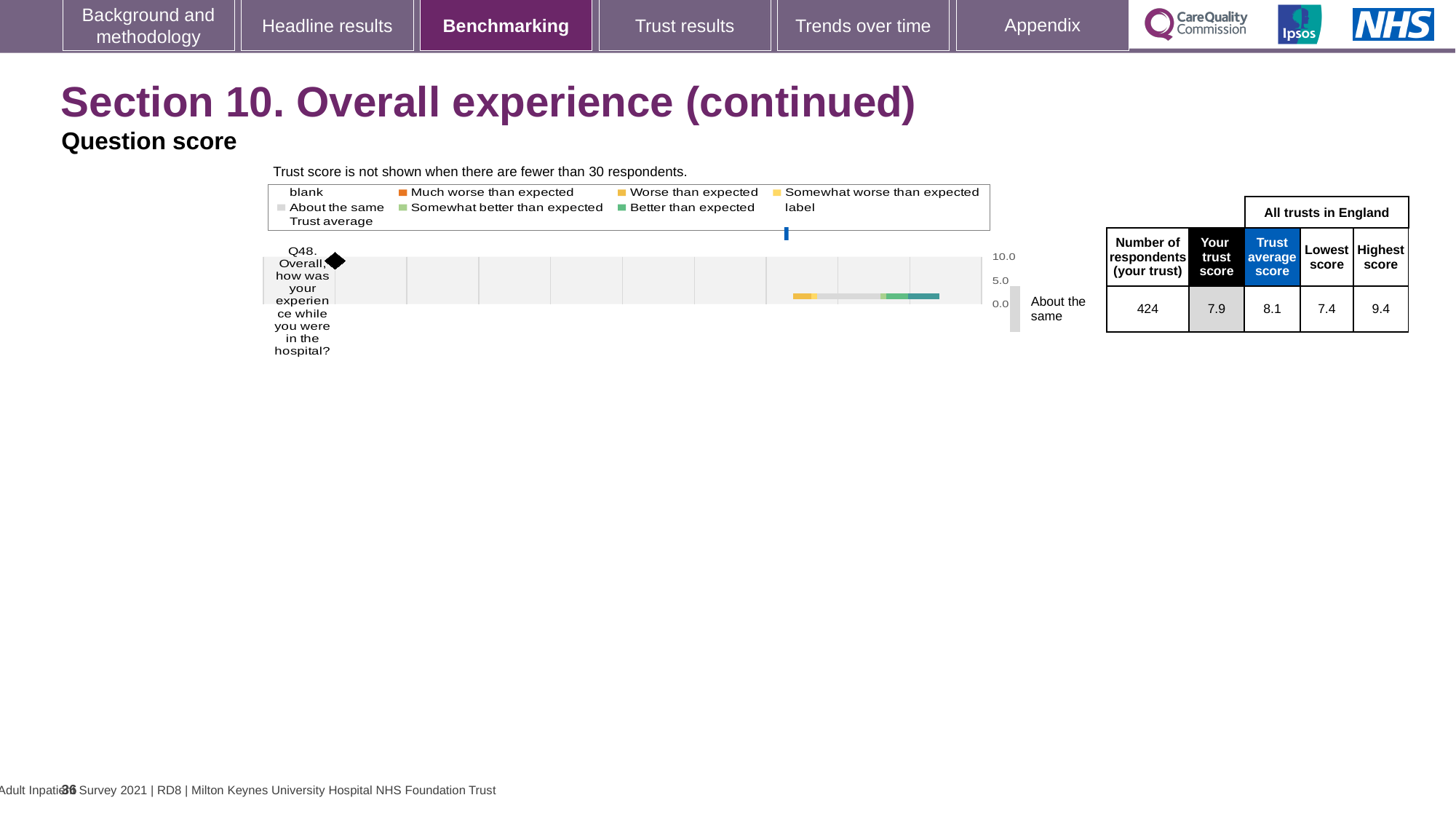
Which is larger for Q48: the trust score or the trust average score? Trust average score What is the highest score among all trusts in England for Q48? 9.4 What kind of chart is used to show the Q48 benchmarking result? Bar chart What is the difference between the highest score and the lowest score for Q48 across all trusts in England? 2.0 How many respondents from the trust answered Q48? 424 Which question is plotted on the chart? Q48. Overall, how was your experience while you were in the hospital? What is the lowest score among all trusts in England for Q48? 7.4 How is the trust's Q48 result categorised relative to expectations? About the same What is the maximum value shown on the chart's score axis? 10.0 What is the trust score for Q48 shown in the table? 7.9 What is the trust average score for Q48 across all trusts in England? 8.1 What is the difference between the trust average score and the trust score for Q48? 0.2